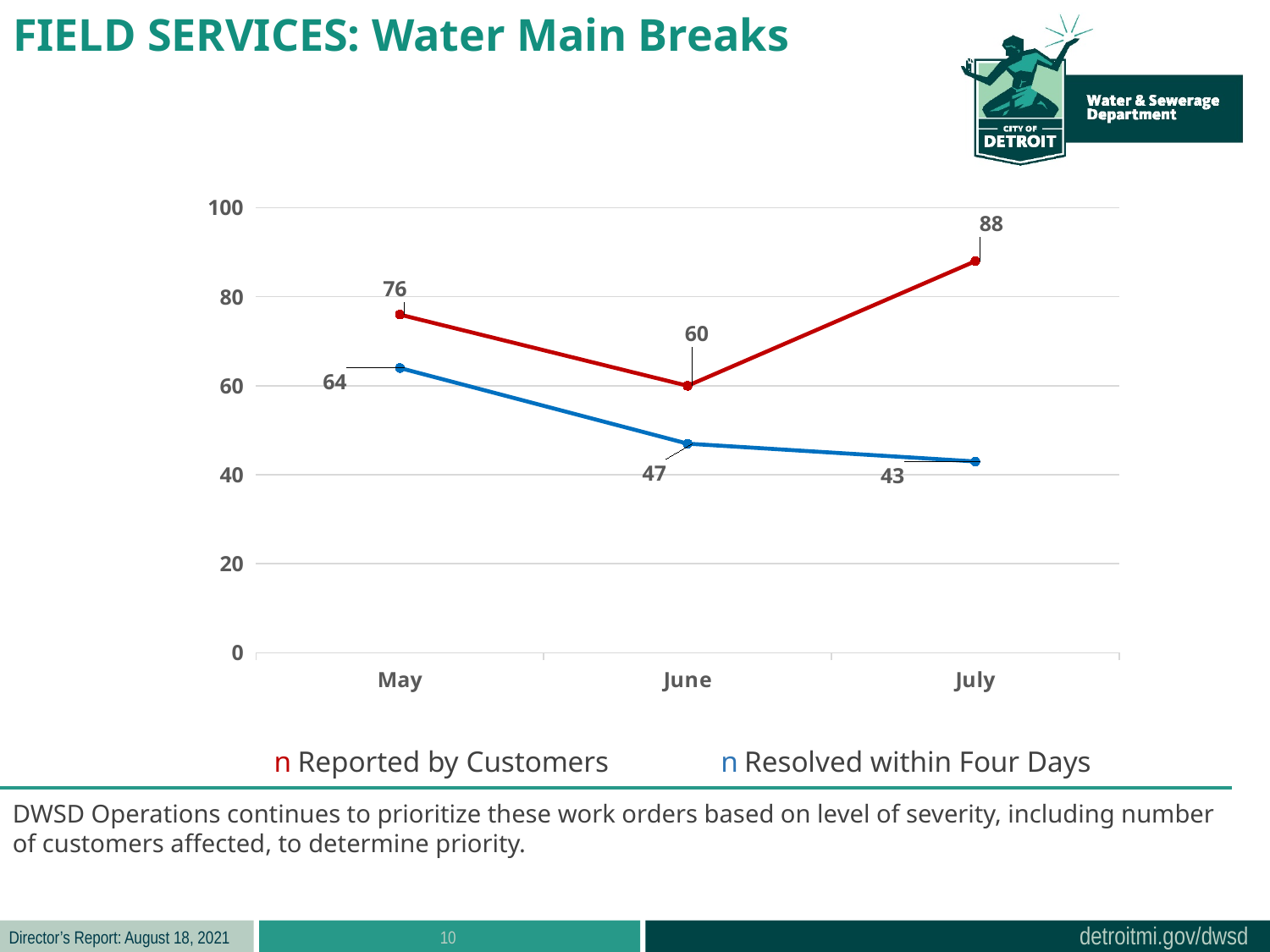
What kind of chart is shown on the slide? line chart How many months are shown on the x axis? 3 Does the Resolved within Four Days series rise or fall from May to July? fall How many series does the legend list? 2 What is the value for Reported by Customers in July? 88 What is the difference between Reported by Customers and Resolved within Four Days in July? 45 In which month is the Reported by Customers value highest? July What is the value for Reported by Customers in June? 60 Is the value for Resolved within Four Days in June greater or less than 60? less What is the value for Resolved within Four Days in May? 64 In which month is the Resolved within Four Days value lowest? July Which is larger in May: Reported by Customers or Resolved within Four Days? Reported by Customers